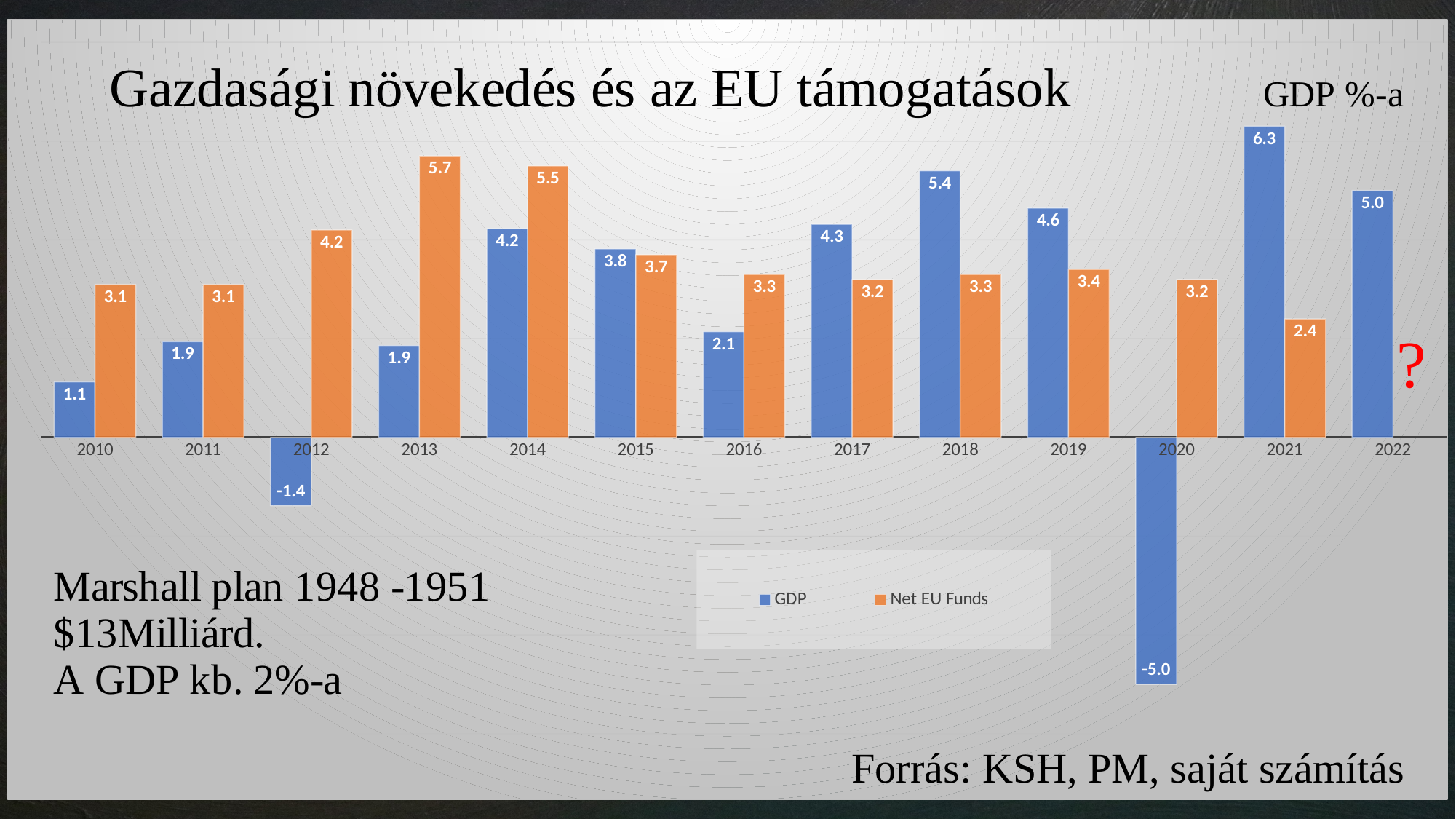
What is the Net EU Funds value for 2021? 2.4 What is the GDP value for 2020? -5.0 Which year has the highest GDP value? 2021 What is the GDP value for 2021? 6.3 What is the difference between the GDP value and the Net EU Funds value in 2018? 2.1 How many series does the legend list? 2 What kind of chart is shown on the slide? Bar chart Which year has the lowest GDP value? 2020 In 2014, which is larger: GDP or Net EU Funds? Net EU Funds What is the Net EU Funds value for 2013? 5.7 How many years are shown on the x axis? 13 Which year has the highest Net EU Funds value? 2013